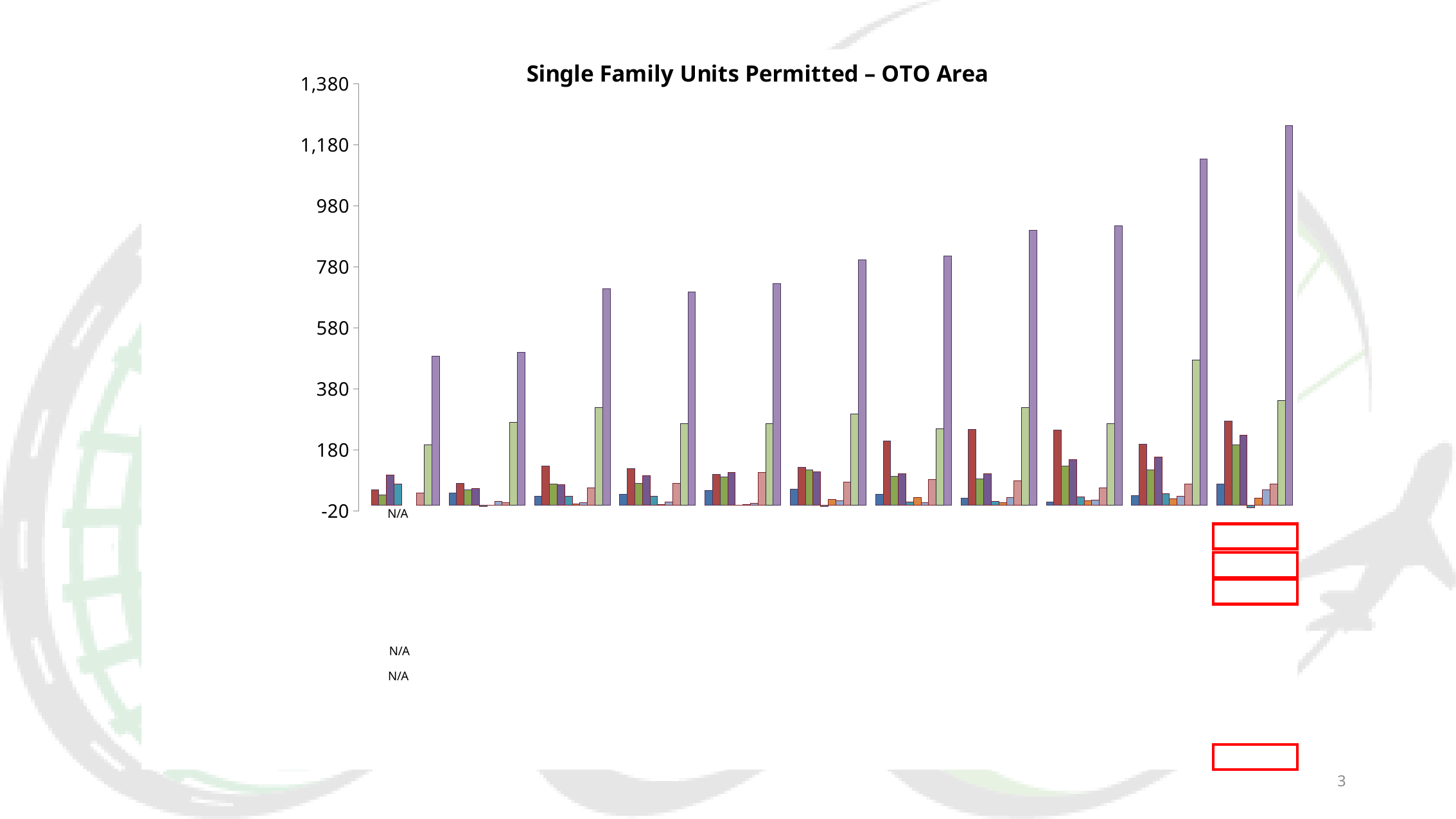
What is the title of the chart? Single Family Units Permitted – OTO Area What kind of chart is shown on the slide? bar chart Is the tallest bar in the second group from the right greater or less than 980? greater Is the tallest bar in the fourth group from the right greater or less than 780? greater What is the highest value shown on the y axis? 1,380 Which group of bars contains the highest bar on the chart? the rightmost group How many groups of bars are plotted along the x axis? 11 Do the tallest (purple) bars generally rise or fall from left to right across the chart? rise Is the tallest bar in the rightmost group greater or less than 1,180? greater